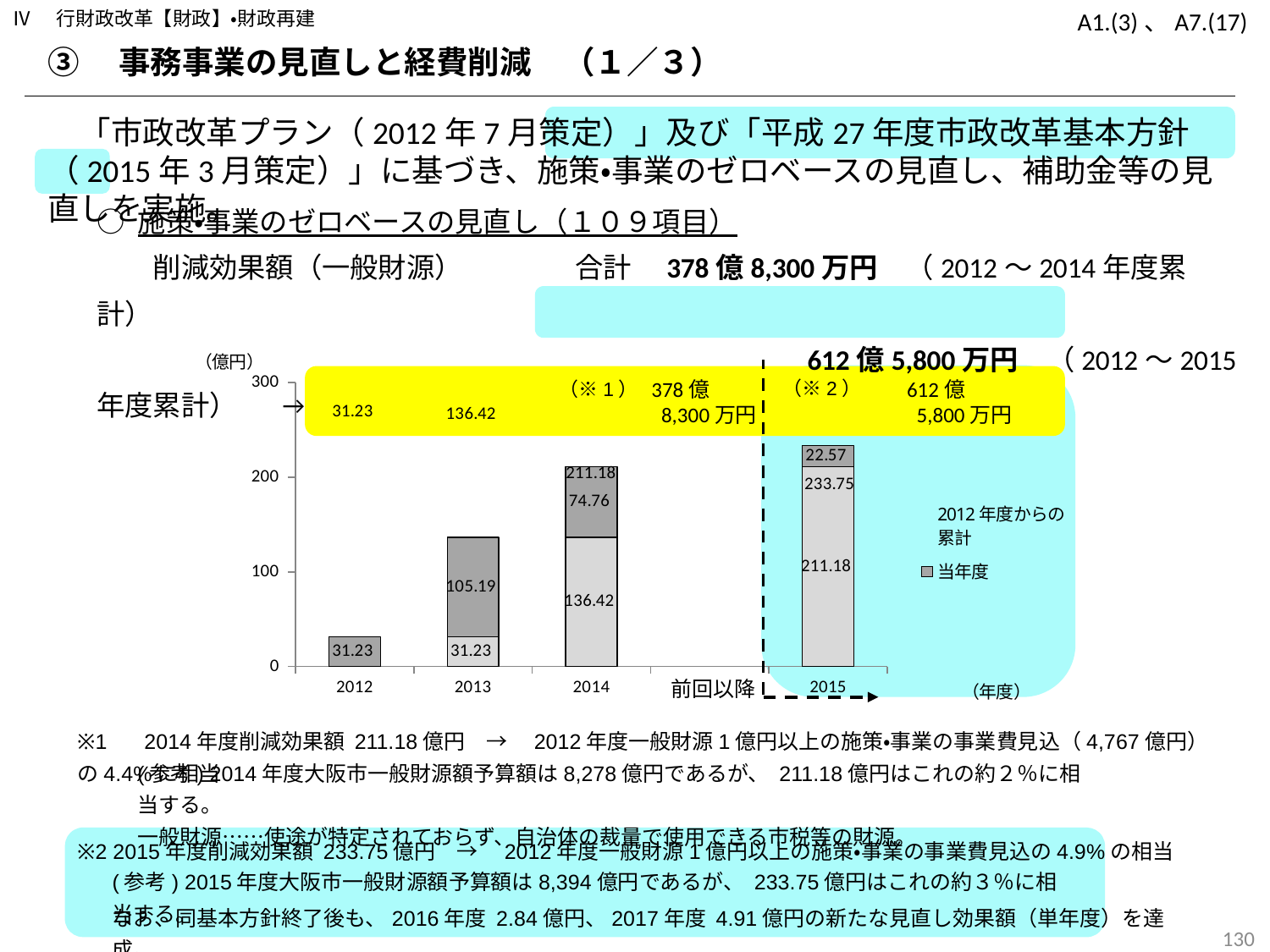
What is the 当年度 value for 2014 in the chart? 74.76 What is the difference between the 当年度 values for 2013 and 2014? 30.43 What is the 当年度 value for 2013 in the chart? 105.19 What is the total of the stacked bar for 2014? 211.18 How many series does the chart's legend list? 2 What is the total of the stacked bar for 2015? 233.75 Which year has the tallest stacked bar in the chart? 2015 How many years (categories) are plotted on the x axis of the chart? 4 What type of chart is shown on the slide? bar chart What is the 当年度 value for 2015 in the chart? 22.57 Is the total value of the 2015 bar greater or less than 200? greater Which year has the shortest bar in the chart? 2012